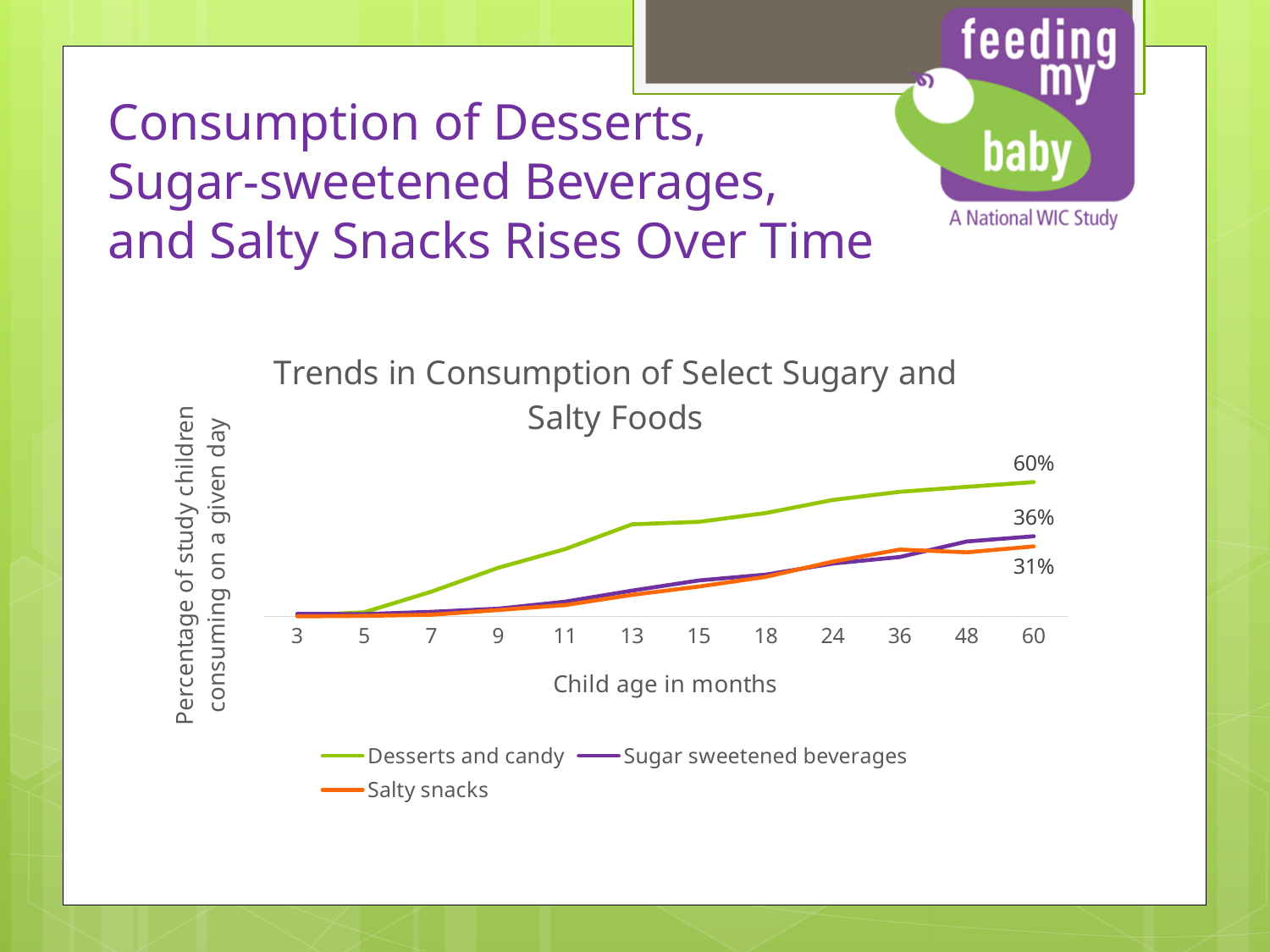
What is the chart's title? Trends in Consumption of Select Sugary and Salty Foods At 60 months, which is larger: sugar sweetened beverages or salty snacks? Sugar sweetened beverages What is the difference in percentage points between desserts and candy and sugar sweetened beverages at 60 months? 24 percentage points What kind of chart is shown on the slide? Line chart What percentage of study children consumed salty snacks at 60 months? 31% Does the desserts and candy line rise or fall as child age increases? Rises How many series does the legend list? 3 What percentage of study children consumed sugar sweetened beverages at 60 months? 36% How many child age points are shown along the x axis? 12 Which series has the highest value at 60 months? Desserts and candy What percentage of study children consumed desserts and candy at 60 months? 60% Which series has the lowest value at 60 months? Salty snacks